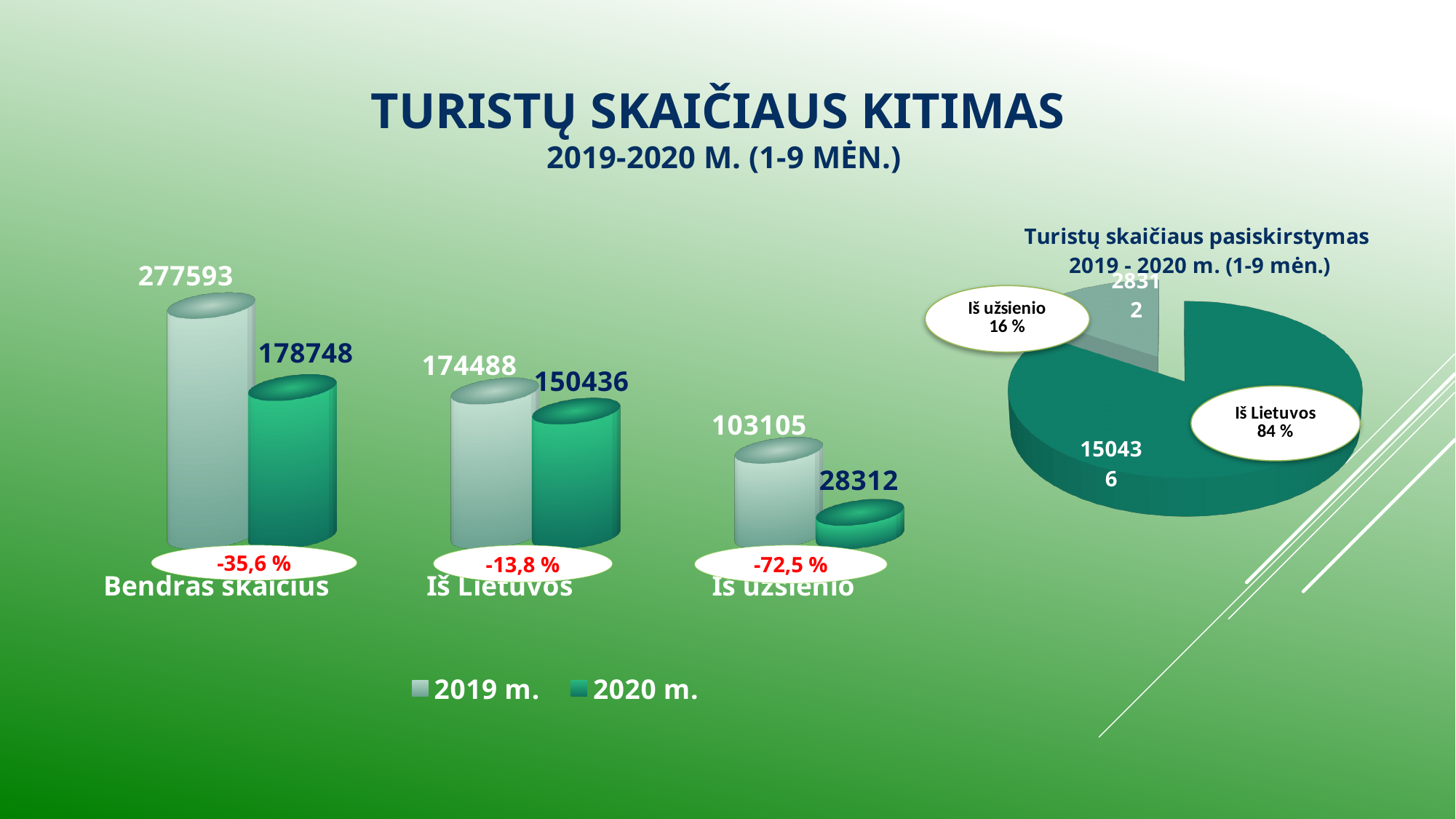
How many categories are shown in the bar chart on the left? 3 How many series does the legend of the bar chart on the left list? 2 In the bar chart on the left, what percentage change is shown for Iš užsienio? -72,5 % What type of chart is the chart on the right of the slide? Pie chart In the bar chart on the left, which category has the lowest 2020 m. value? Iš užsienio In the bar chart on the left, what is the 2019 m. value for Bendras skaičius? 277593 In the bar chart on the left, what is the 2020 m. value for Iš užsienio? 28312 In the bar chart on the left, which is larger for Iš užsienio: the 2019 m. value or the 2020 m. value? 2019 m. In the bar chart on the left, what is the difference between the 2019 m. and 2020 m. values for Iš Lietuvos? 24052 In the bar chart on the left, what is the 2020 m. value for Iš Lietuvos? 150436 In the bar chart on the left, which category has the highest 2019 m. value? Bendras skaičius In the pie chart titled 'Turistų skaičiaus pasiskirstymas', what share does Iš Lietuvos have? 84 %